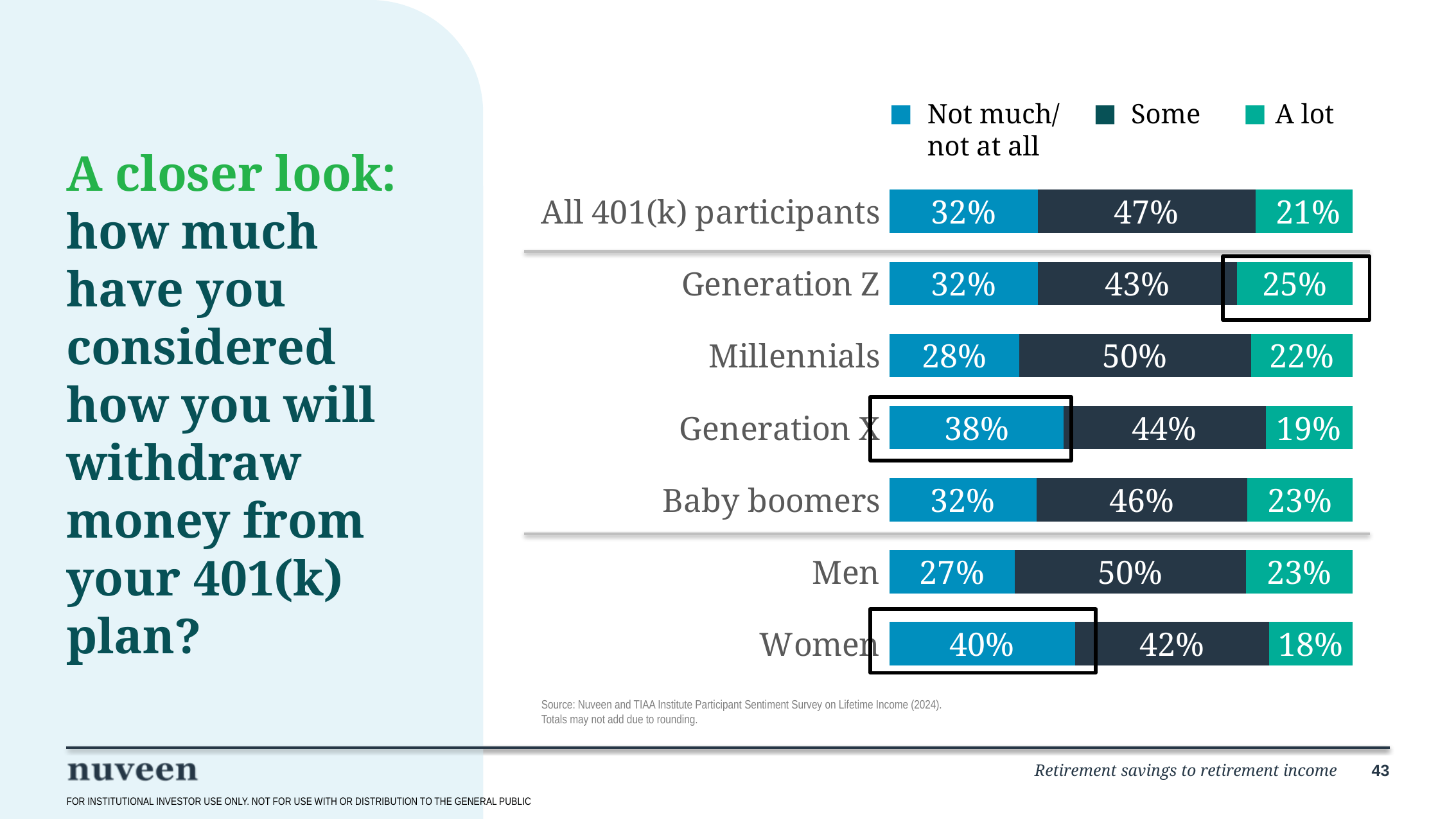
Which has a larger "Not much/not at all" share, Generation X or Baby boomers? Generation X What percentage of Millennials answered "Some"? 50% What percentage of Generation Z answered "A lot"? 25% Which group has the highest share answering "Not much/not at all"? Women Which group has the lowest share answering "Not much/not at all"? Men How many response categories does the legend list? 3 Which group has the lowest share answering "A lot"? Women Which group has the highest share answering "A lot"? Generation Z What percentage of Women answered "Not much/not at all"? 40% What type of chart is shown on the slide? Stacked bar chart How many groups (bars) are shown in the chart? 7 How many percentage points higher is the "Not much/not at all" share for Women than for Men? 13 percentage points